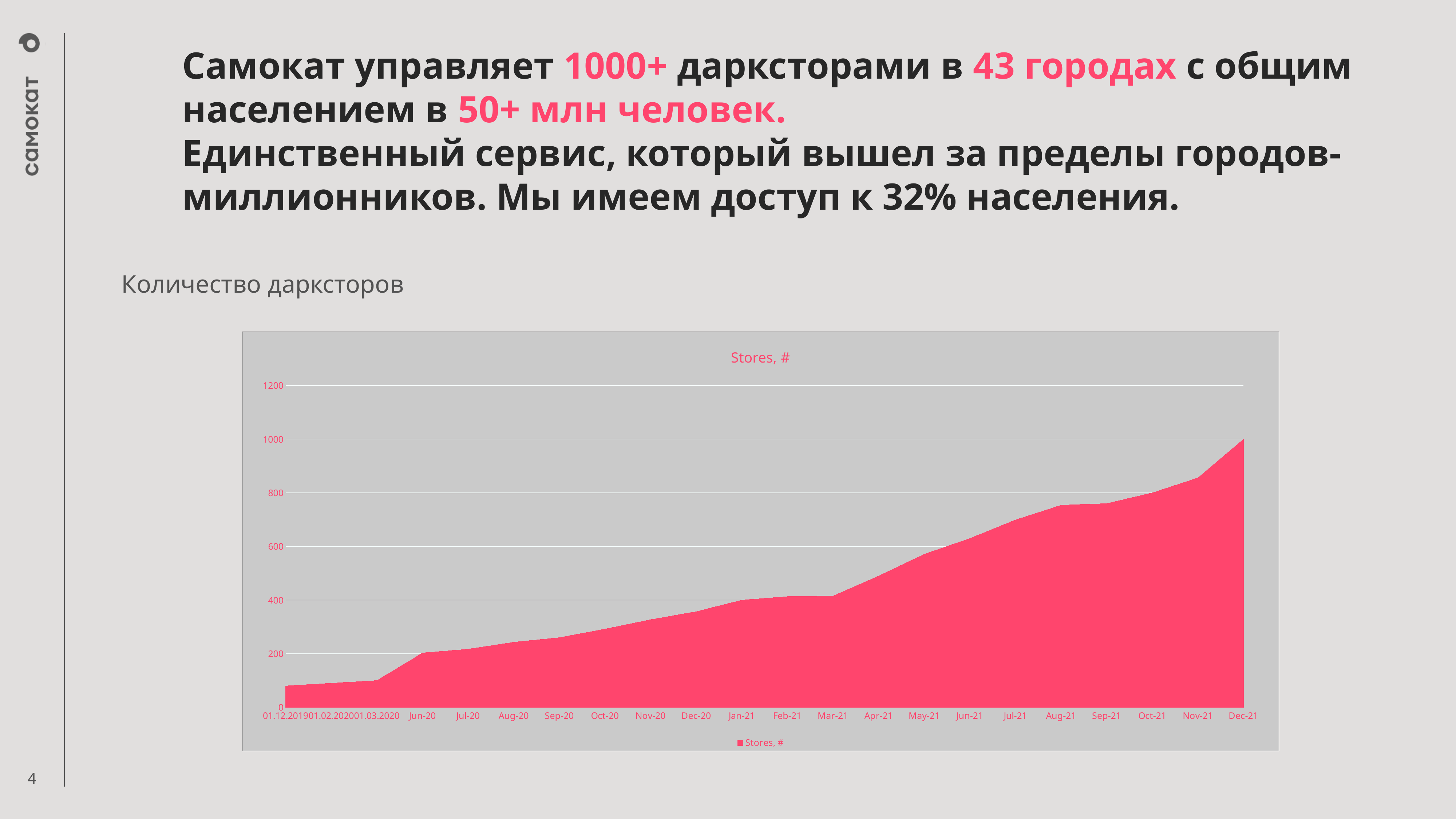
What is the title of the chart? Stores, # Is the value for Dec-20 greater or less than 400? less Which point has the lowest value? 01.12.2019 How many series does the legend list? 1 How many points are plotted along the x axis? 22 Which point has the highest value? Dec-21 Is the value for Nov-21 greater or less than 800? greater Is the value for Sep-20 greater or less than 200? greater Do the values rise or fall along the x axis from 01.12.2019 to Dec-21? rise Which is larger, the value for Apr-21 or the value for Oct-20? Apr-21 What kind of chart is shown on the slide? area chart